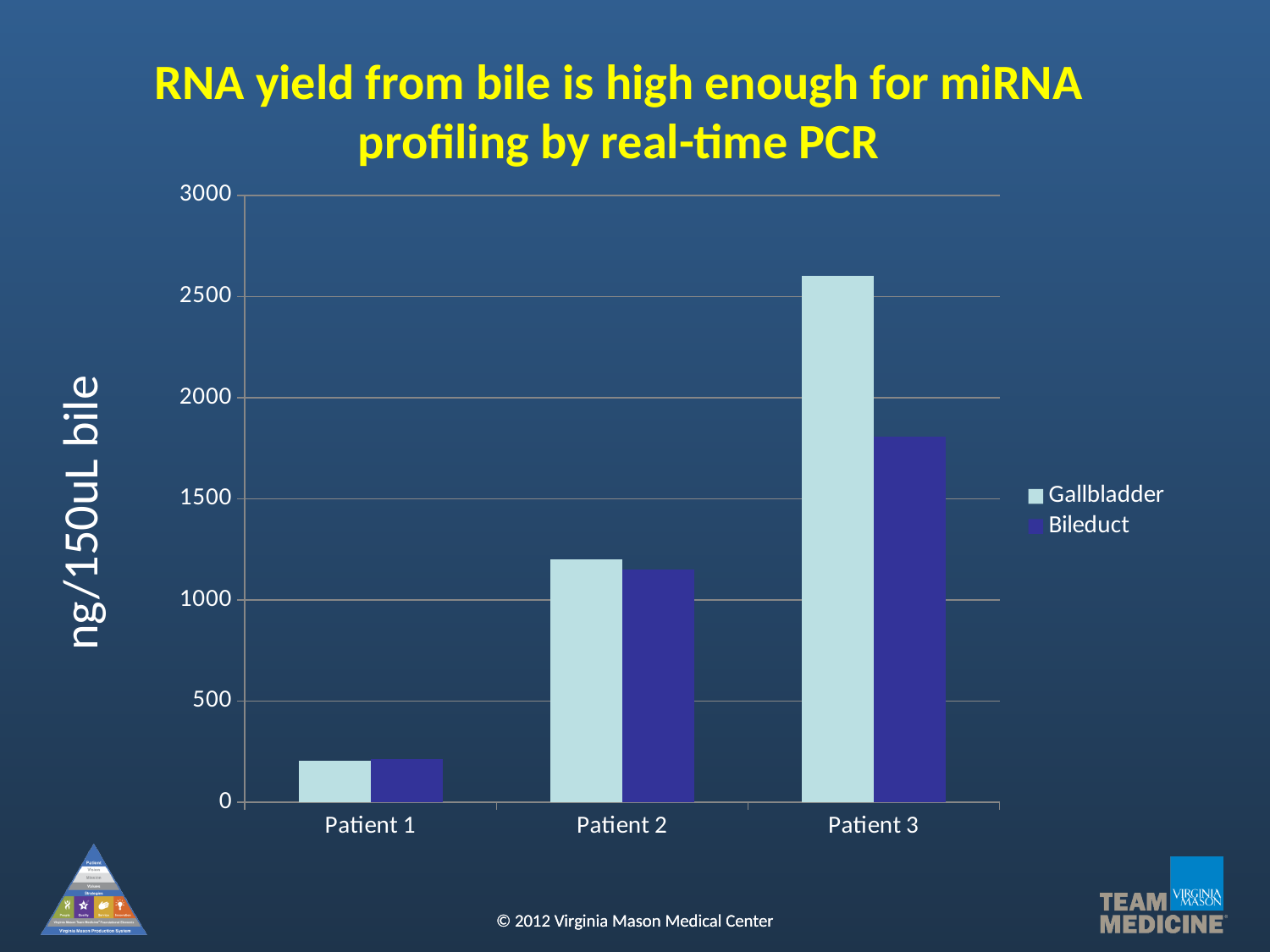
Do the Gallbladder values rise or fall from Patient 1 to Patient 3? rise Is the Bileduct value for Patient 1 greater or less than 500? less Is the Gallbladder value for Patient 2 greater or less than 1000? greater For Patient 3, which is larger, the Gallbladder value or the Bileduct value? Gallbladder Is the Gallbladder value for Patient 3 greater or less than 2500? greater What is the label on the y axis? ng/150uL bile Which patient has the lowest Bileduct value? Patient 1 What kind of chart is shown on the slide? bar chart Which patient has the highest Gallbladder value? Patient 3 How many series does the legend list? 2 How many patients are shown on the x axis? 3